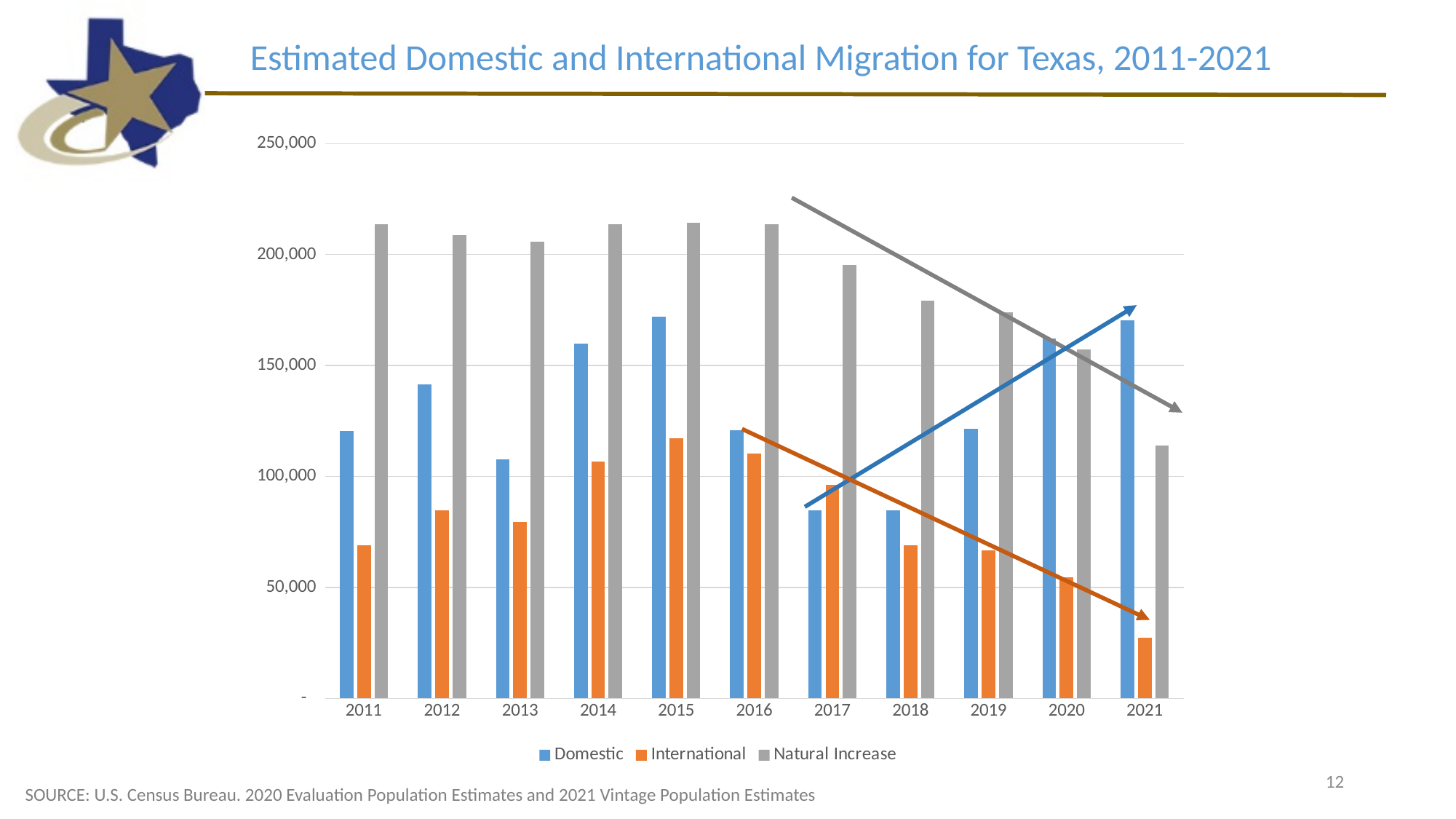
Is the International value for 2021 greater or less than 50,000? less Which year has the lowest Natural Increase value? 2021 What kind of chart is shown on the slide? Bar chart In 2021, which is larger: the Domestic value or the Natural Increase value? Domestic Is the Domestic value for 2017 greater or less than 100,000? less Does the International series rise or fall from 2015 to 2021? Fall Which year has the highest International value? 2015 Is the Domestic value for 2015 greater or less than 150,000? greater Which year has the lowest International value? 2021 How many series does the legend list? 3 How many years are shown on the x axis? 11